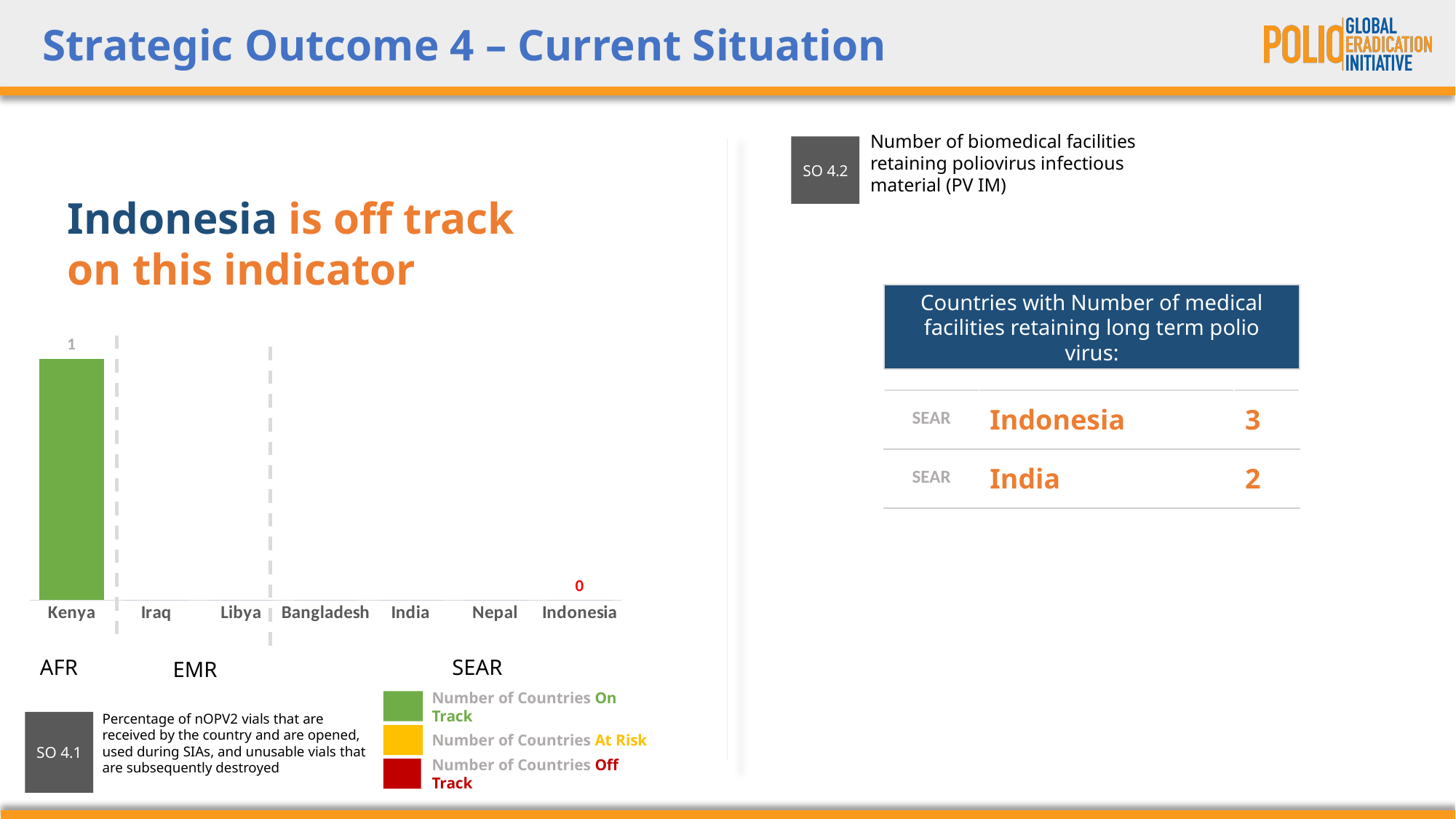
Which legend entry in the bar chart is shown in green? Number of Countries On Track In the bar chart, what is the value shown for Kenya? 1 Which country in the bar chart has a visible bar? Kenya In the bar chart, what is the value shown for Indonesia? 0 Which legend entry in the bar chart is shown in red? Number of Countries Off Track What is the difference between the value for Kenya and the value for Indonesia in the bar chart? 1 Which region group does Kenya belong to in the bar chart? AFR In the bar chart, which is larger, the value for Kenya or the value for Indonesia? Kenya How many series does the legend of the bar chart list? 3 How many countries are listed along the x axis of the bar chart? 7 What type of chart is shown on the left of the slide? bar chart Which country has the highest value in the bar chart? Kenya